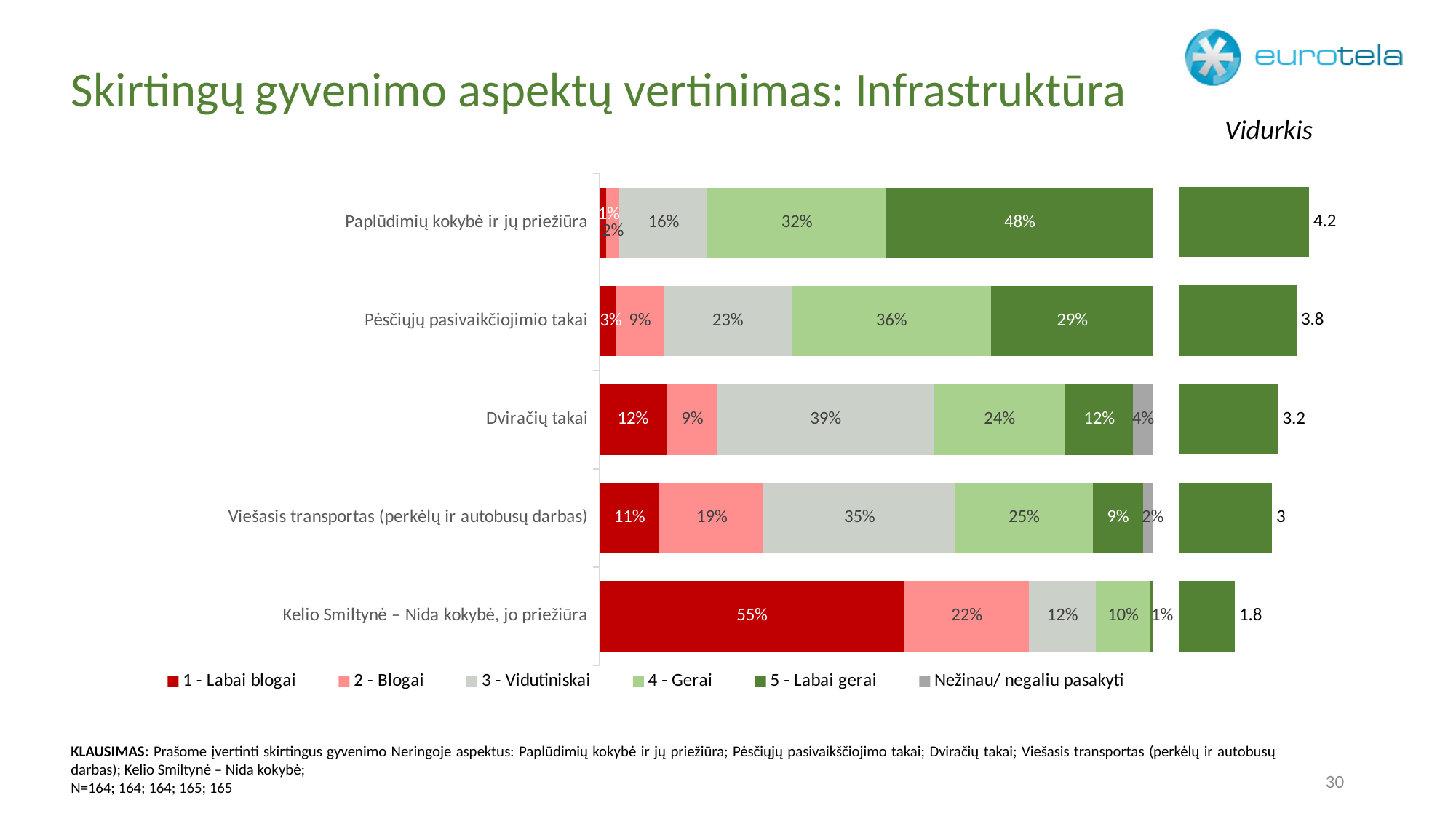
In the 'Vidurkis' chart, which category has the highest average? Paplūdimių kokybė ir jų priežiūra In the 'Vidurkis' chart, what is the difference between the averages for 'Paplūdimių kokybė ir jų priežiūra' and 'Viešasis transportas (perkėlų ir autobusų darbas)'? 1.2 In the stacked bar chart, which category has the largest '1 - Labai blogai' share? Kelio Smiltynė – Nida kokybė, jo priežiūra In the stacked bar chart, what is the '3 - Vidutiniskai' share for 'Dviračių takai'? 39% In the stacked bar chart, what percentage of respondents rated 'Paplūdimių kokybė ir jų priežiūra' as '5 - Labai gerai'? 48% In the stacked bar chart, what is the difference between the '4 - Gerai' shares for 'Pėsčiųjų pasivaikčiojimio takai' and 'Dviračių takai'? 12% In the 'Vidurkis' chart, what is the average value for 'Pėsčiųjų pasivaikčiojimio takai'? 3.8 In the stacked bar chart, which is larger: the '2 - Blogai' share for 'Viešasis transportas (perkėlų ir autobusų darbas)' or for 'Dviračių takai'? Viešasis transportas (perkėlų ir autobusų darbas) How many series does the legend of the stacked bar chart list? 6 In the stacked bar chart, what is the '1 - Labai blogai' share for 'Kelio Smiltynė – Nida kokybė, jo priežiūra'? 55% In the 'Vidurkis' chart, which category has the lowest average? Kelio Smiltynė – Nida kokybė, jo priežiūra How many categories are shown in the stacked bar chart? 5